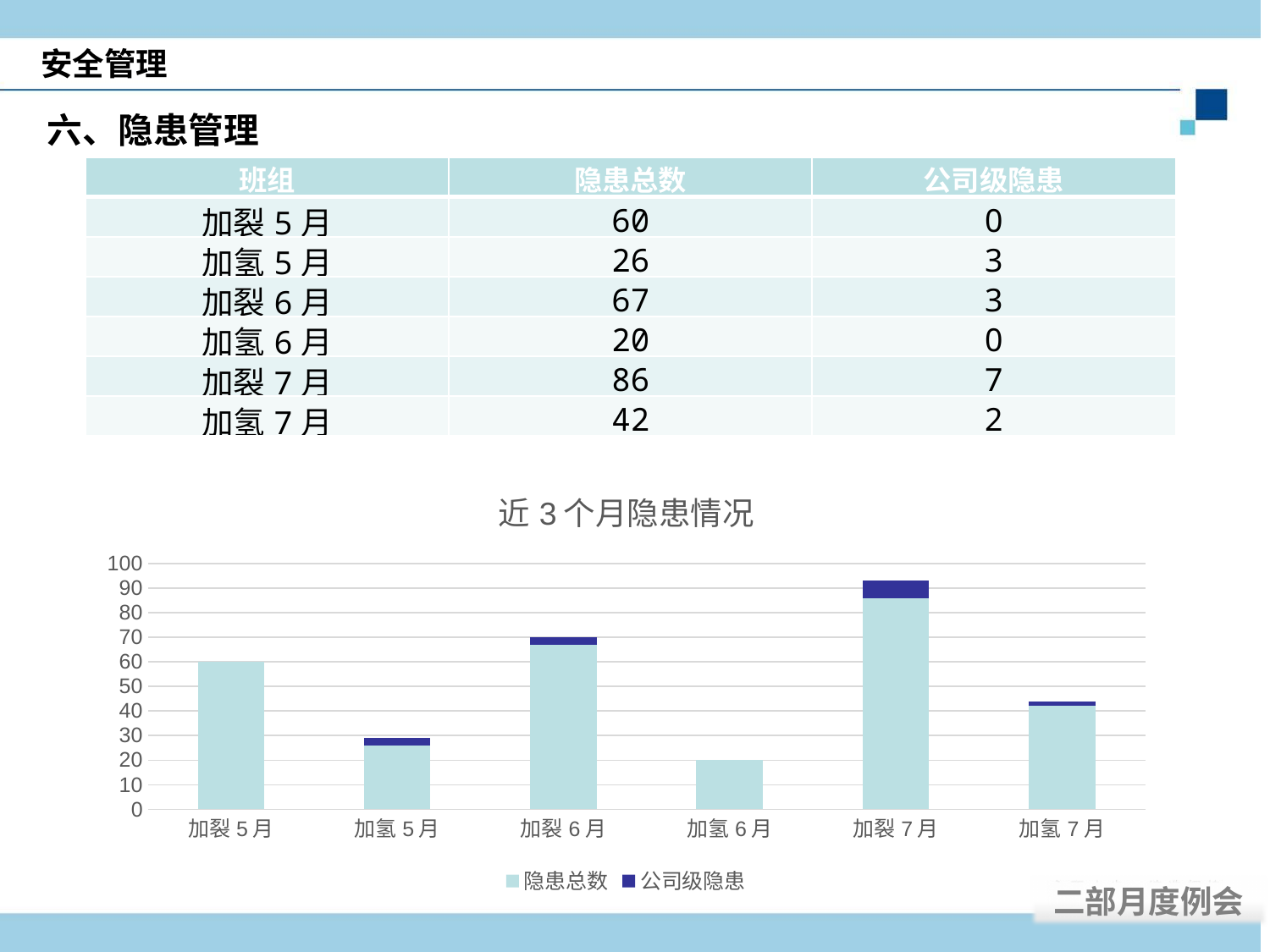
What is the 隐患总数 value for 加裂7月? 86 What kind of chart is shown on the slide? bar chart How many series does the chart legend list? 2 Which category has the lowest 隐患总数? 加氢6月 What is the total of the stacked bar for 加裂7月? 93 Which has a larger 隐患总数, 加氢7月 or 加氢5月? 加氢7月 What is the difference in 隐患总数 between 加裂6月 and 加裂5月? 7 What is the title of the chart? 近3个月隐患情况 How many categories are shown on the x axis of the chart? 6 Is the 隐患总数 value for 加裂6月 greater or less than 60? greater What is the 公司级隐患 value for 加氢5月? 3 Which category has the highest 隐患总数? 加裂7月